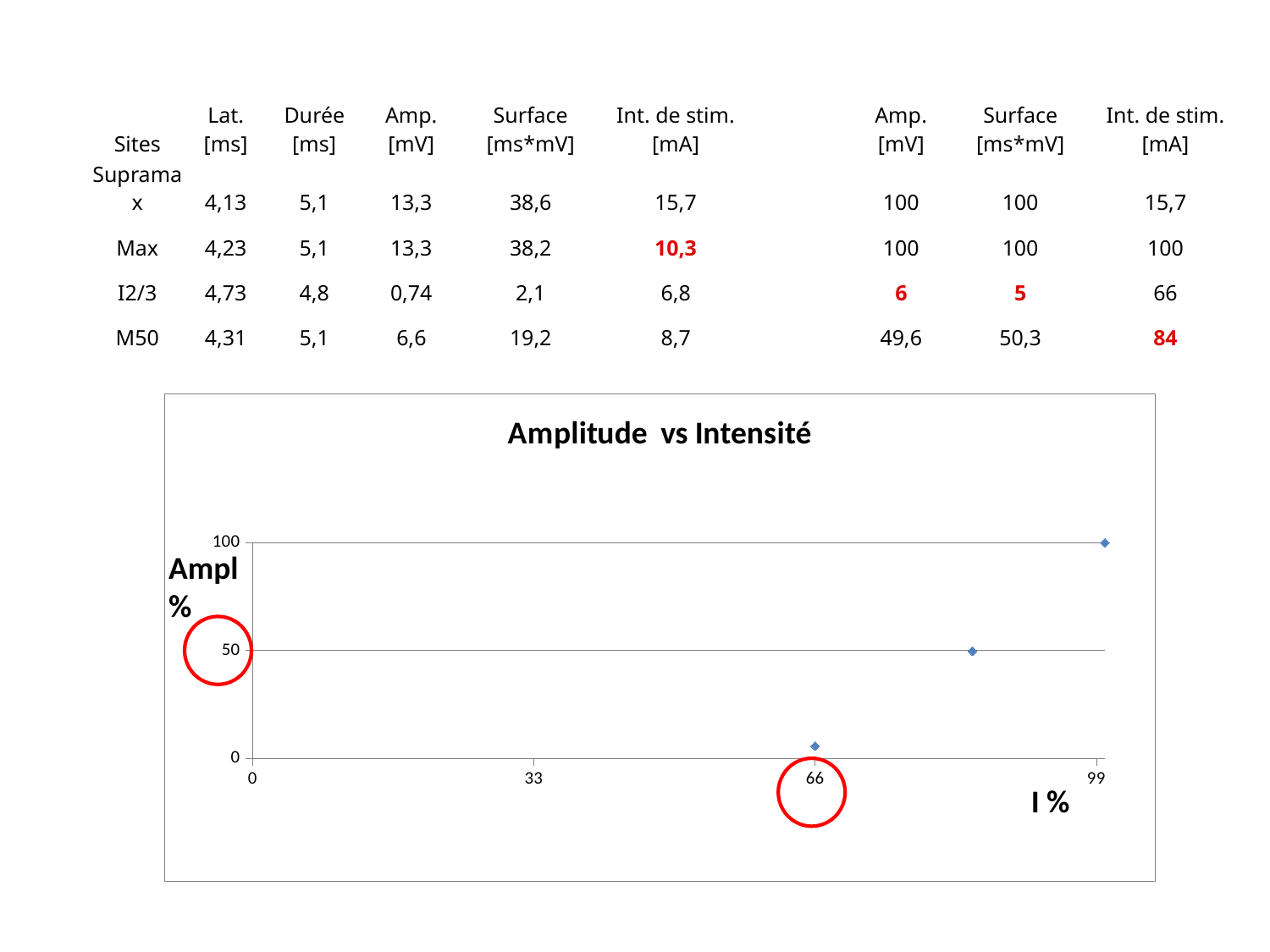
What is the amplitude (Ampl %) of the highest plotted point? 100 What kind of chart is shown on the slide? scatter chart Is the I % value of the middle plotted point greater or less than 99? less What label is shown on the x axis of the chart? I % Is the amplitude of the point at I % = 66 greater or less than 50? less What is the x-axis (I %) value of the leftmost plotted point? 66 Is the amplitude of the rightmost plotted point greater or less than 50? greater Do the plotted amplitude values rise or fall as intensity increases along the x axis? rise How many data points are plotted in the chart? 3 Which plotted point has the lowest amplitude: the one at I % = 66, the middle point, or the rightmost point? the one at I % = 66 What is the title of the chart? Amplitude vs Intensité